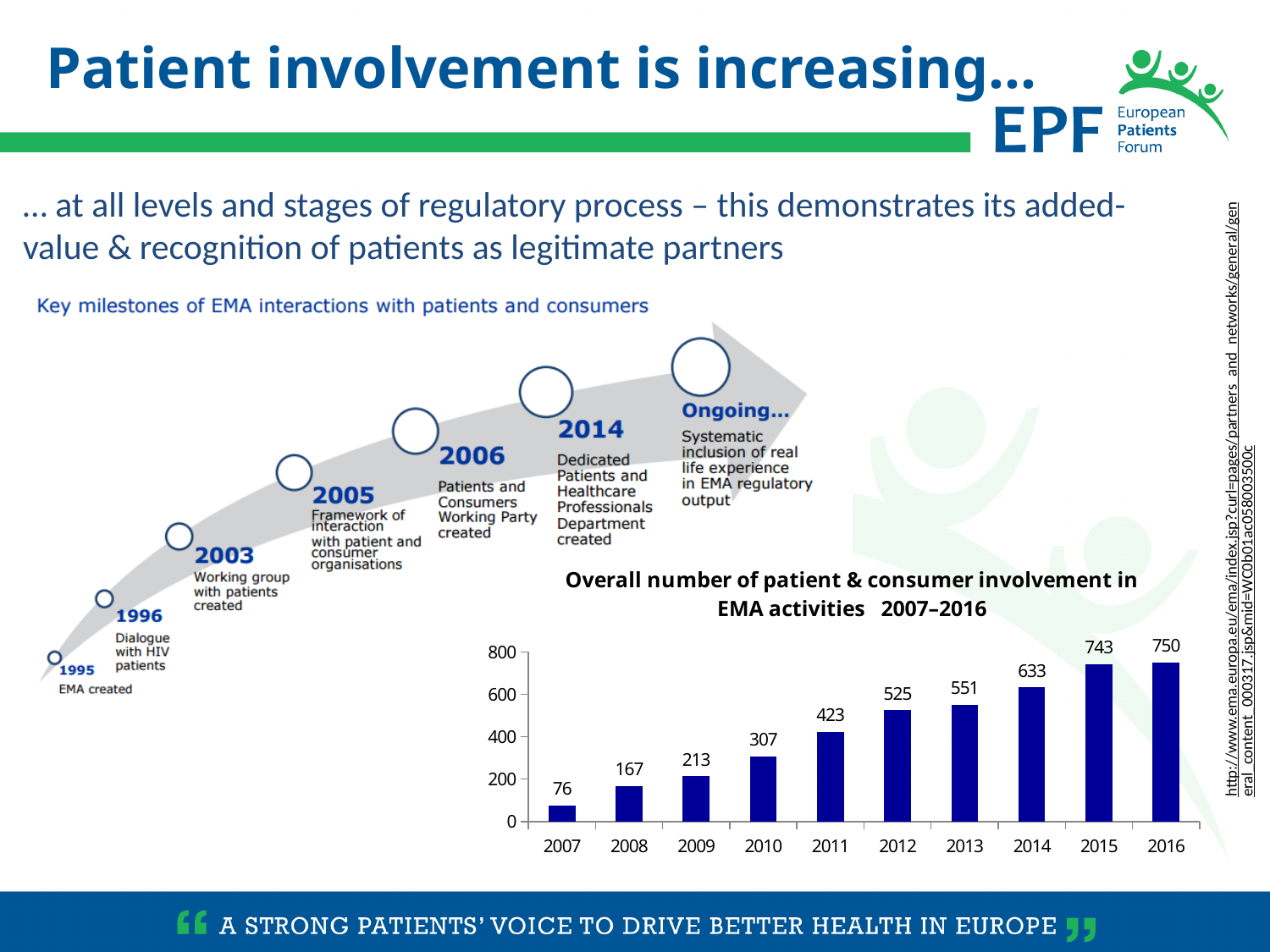
What kind of chart is used to show the overall number of patient & consumer involvement in EMA activities? bar chart Which is larger in the bar chart, the value for 2013 or the value for 2012? 2013 How many years are shown on the x axis of the bar chart? 10 Is the value for 2015 in the bar chart greater or less than 600? greater Which year has the highest value in the bar chart? 2016 What is the difference between the values for 2011 and 2010 in the bar chart? 116 What is the value for 2012 in the bar chart? 525 Do the values in the bar chart rise or fall from 2007 to 2016? rise What is the difference between the values for 2016 and 2007 in the bar chart? 674 What is the value for 2014 in the bar chart? 633 Which year has the lowest value in the bar chart? 2007 What is the value for 2007 in the chart 'Overall number of patient & consumer involvement in EMA activities 2007–2016'? 76